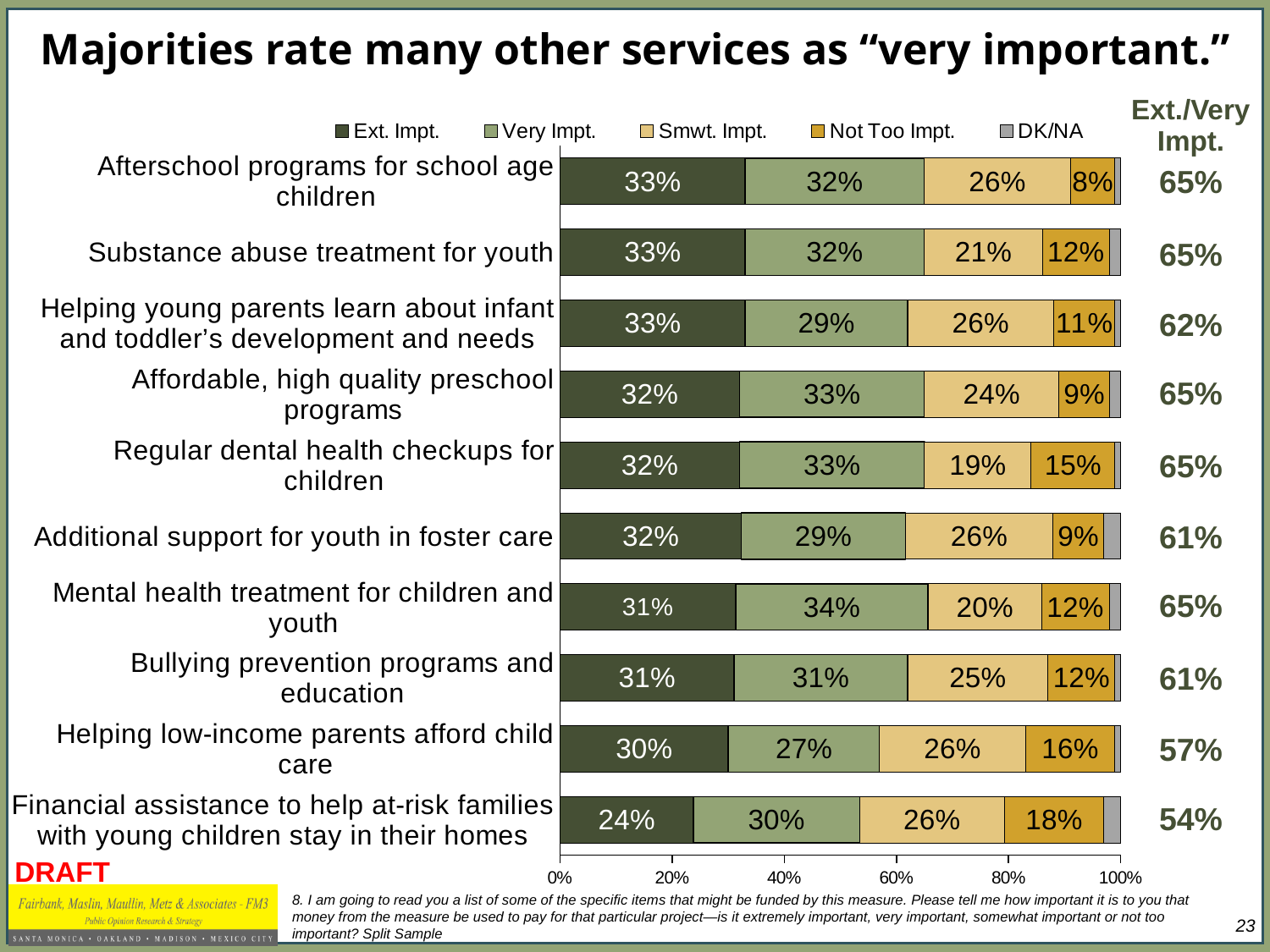
What percentage rated "Substance abuse treatment for youth" as Ext. Impt.? 33% What is the Smwt. Impt. value for "Regular dental health checkups for children"? 19% Which service has the lowest Ext. Impt. percentage? Financial assistance to help at-risk families with young children stay in their homes How many percentage points higher is the Ext. Impt. value for "Afterschool programs for school age children" than for "Financial assistance to help at-risk families with young children stay in their homes"? 9 percentage points What is the Very Impt. value for "Mental health treatment for children and youth"? 34% How many series does the legend list? 5 Which has a larger Very Impt. value: "Bullying prevention programs and education" or "Helping low-income parents afford child care"? Bullying prevention programs and education What kind of chart is shown on the slide? Stacked bar chart Which service has the highest Not Too Impt. percentage? Financial assistance to help at-risk families with young children stay in their homes What is the Not Too Impt. value for "Financial assistance to help at-risk families with young children stay in their homes"? 18% What is the combined Ext./Very Impt. percentage for "Helping low-income parents afford child care"? 57% How many services are listed in the chart? 10